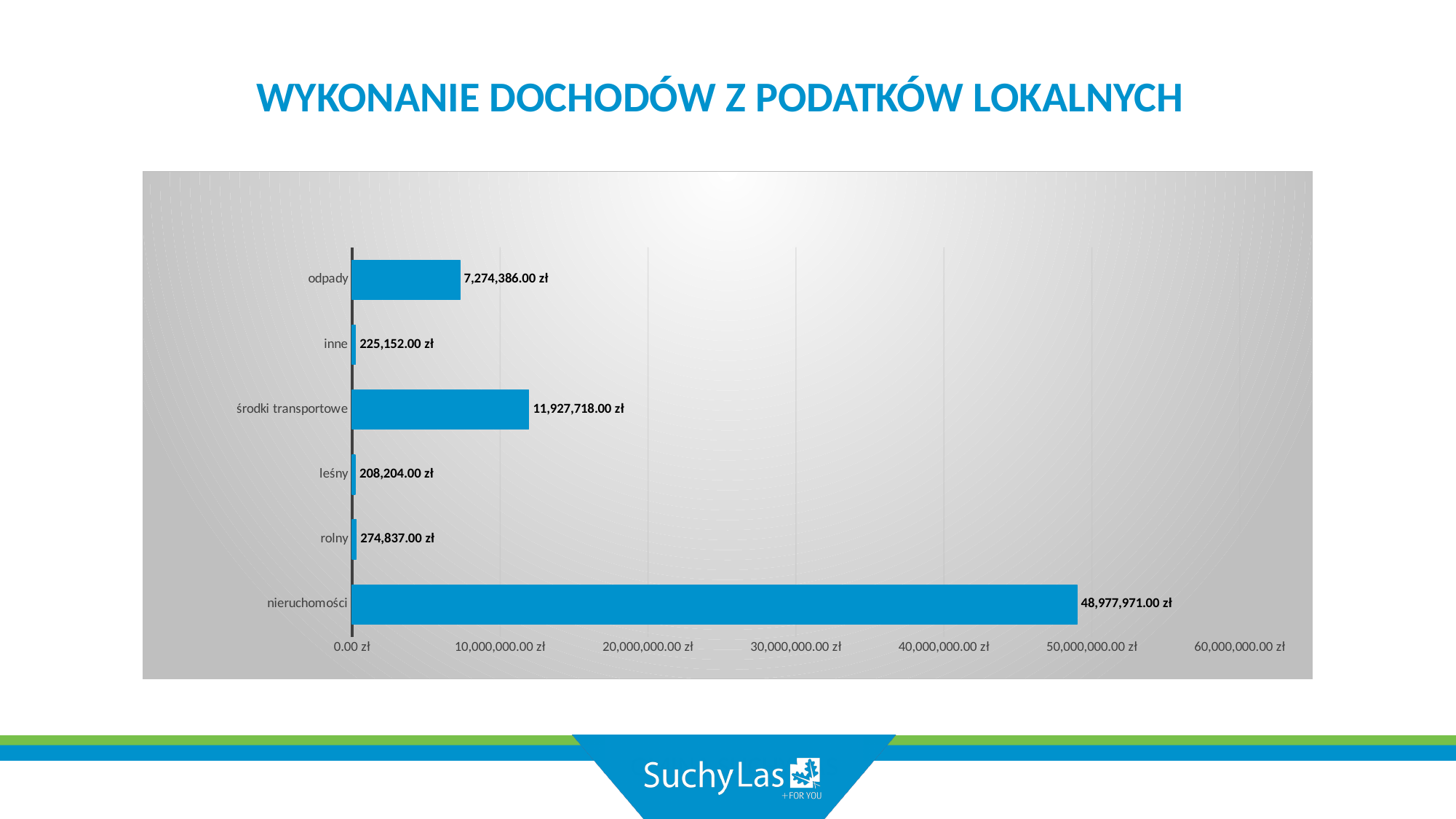
Which is larger, the value for odpady or the value for środki transportowe? środki transportowe What is the difference between the values for rolny and leśny? 66,633.00 zł Which category has the lowest value? leśny What is the value for odpady? 7,274,386.00 zł Which category has the highest value? nieruchomości What is the value for leśny? 208,204.00 zł How many categories are shown in the chart? 6 What is the value for środki transportowe? 11,927,718.00 zł What kind of chart is shown on the slide? bar chart What is the difference between the values for nieruchomości and środki transportowe? 37,050,253.00 zł Is the value for nieruchomości greater or less than 40,000,000.00 zł? greater What is the value for nieruchomości? 48,977,971.00 zł